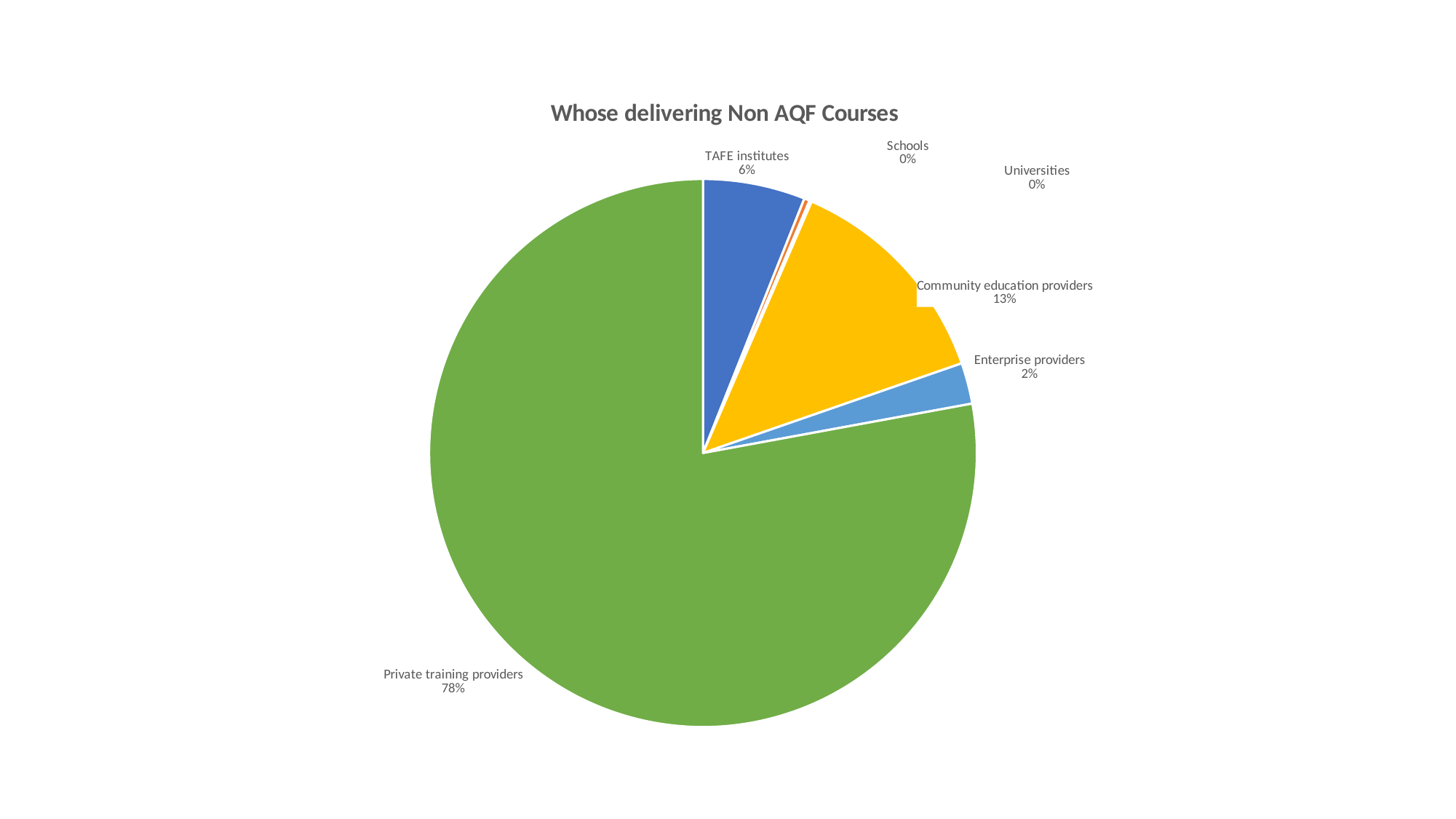
What is the title of the chart? Whose delivering Non AQF Courses What percentage is shown for TAFE institutes? 6% What percentage is shown for Community education providers? 13% Which is larger, the share for Community education providers or the share for TAFE institutes? Community education providers What percentage is shown for Enterprise providers? 2% How many categories are labelled on the pie chart? 6 What type of chart is shown on the slide? pie chart Which category has the largest slice of the pie? Private training providers What colour is the slice for Private training providers? green What percentage is shown for Schools? 0% What share of the pie do Private training providers hold? 78% What is the difference in percentage points between Private training providers and Community education providers? 65